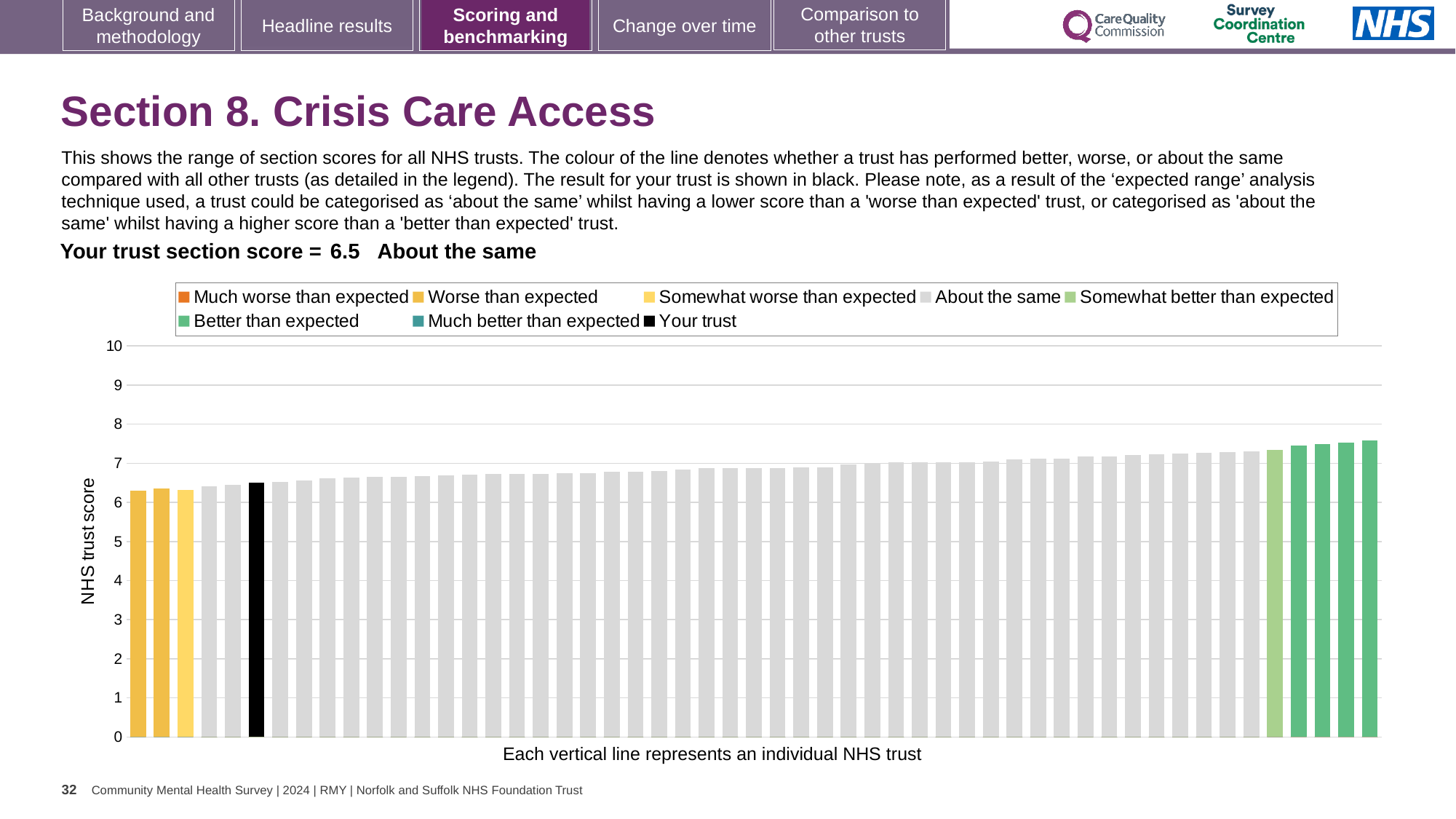
What is the section score for your trust shown on the slide? 6.5 Which is larger: the value of the black 'Your trust' bar or the value of the rightmost bar? the rightmost bar How many entries does the chart legend list? 8 How many bars are coloured as 'Much worse than expected' (orange)? 0 What kind of chart is shown on the slide? bar chart Do the bar values rise or fall from left to right across the chart? rise Is the value for your trust (the black bar) greater or less than 5? greater Is the value of the tallest bar in the chart greater or less than 7? greater How many bars are coloured as 'Better than expected' (green)? 4 Is the value of the leftmost bar in the chart greater or less than 7? less Which category is your trust placed in for this section? About the same How many bars are coloured as 'Worse than expected' (yellow)? 2